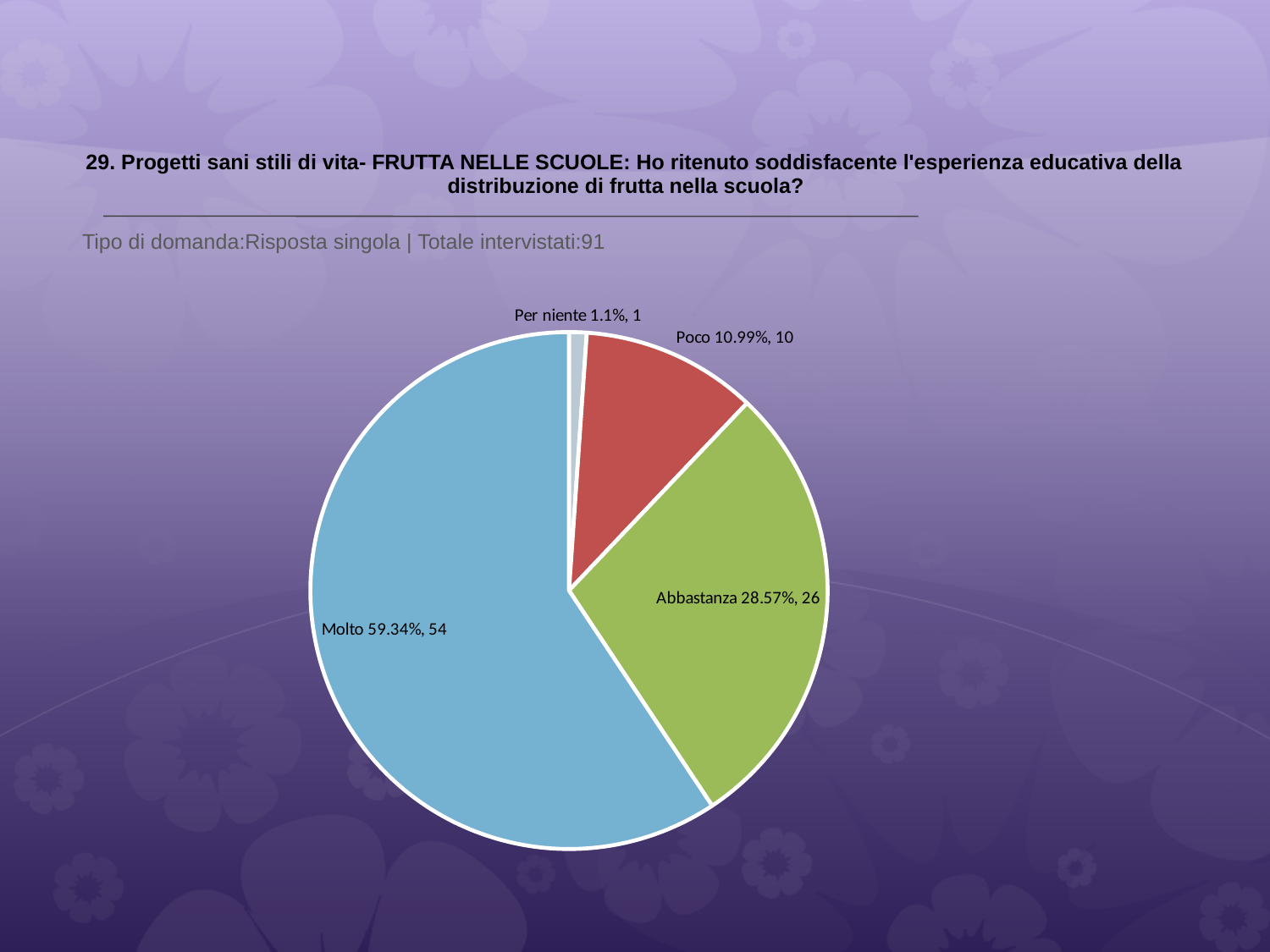
How many respondents answered 'Abbastanza'? 26 What percentage share does the 'Molto' slice have? 59.34% Which category has the largest slice? Molto Which category has the smallest slice? Per niente How many respondents answered 'Per niente'? 1 What is the difference in respondent count between 'Molto' and 'Abbastanza'? 28 What percentage share does the 'Poco' slice have? 10.99% What colour is the 'Molto' slice? blue Which has more respondents, 'Poco' or 'Abbastanza'? Abbastanza What kind of chart is shown on the slide? pie chart What is the total number of respondents shown on the slide? 91 How many slices does the pie chart have? 4